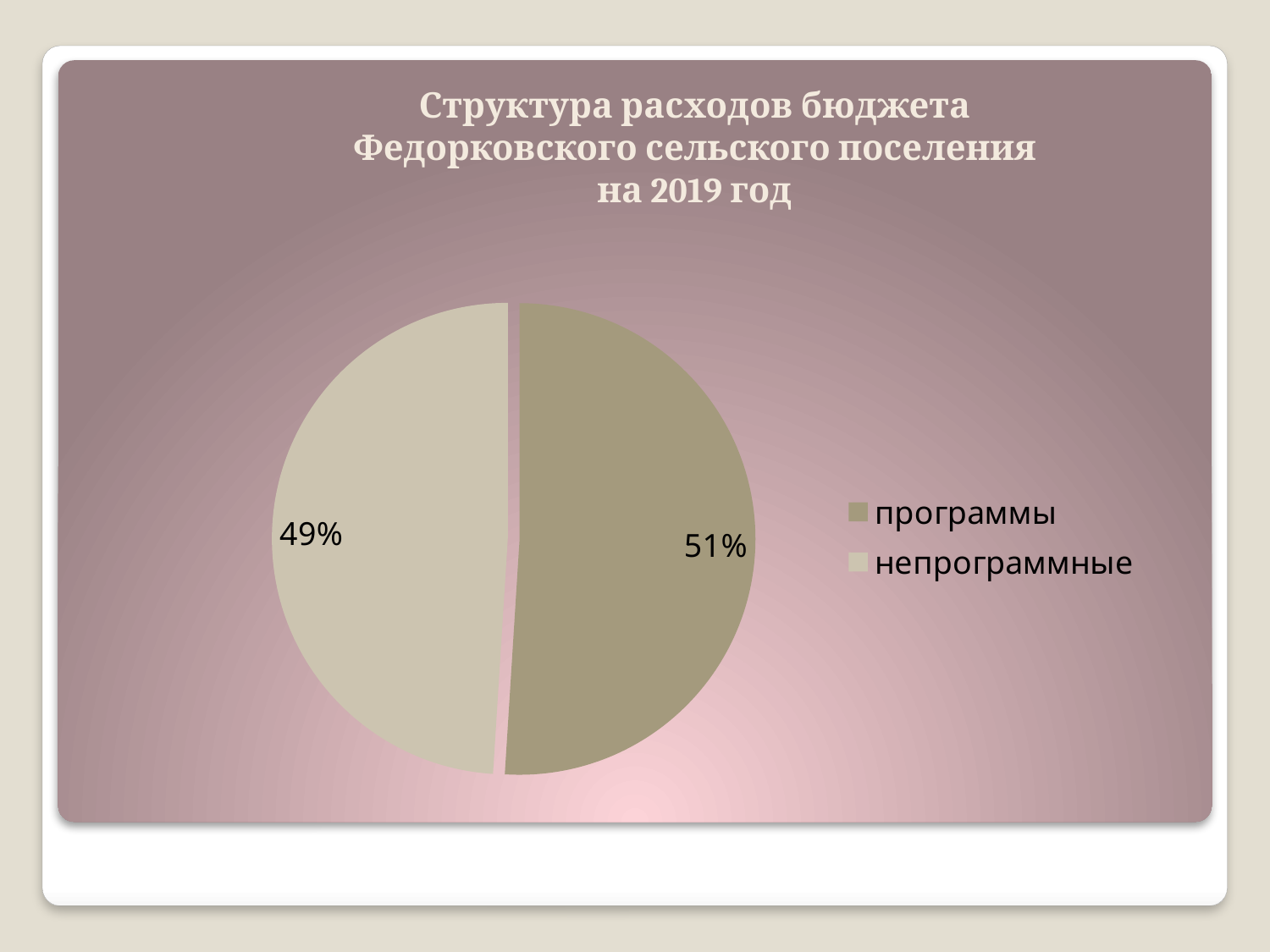
What share of the pie does the "программы" slice represent? 51% What year does the chart title refer to? 2019 How many slices does the pie chart have? 2 Which is larger: the "программы" slice or the "непрограммные" slice? программы How many entries does the legend list? 2 Which legend entry is shown in the lighter colour? непрограммные What share of the pie does the "непрограммные" slice represent? 49% Which category has the smallest slice of the pie? непрограммные What is the total of the two slices shown in the pie chart? 100% What is the difference in percentage points between the "программы" and "непрограммные" slices? 2% What kind of chart is shown on the slide? pie chart Which category has the largest slice of the pie? программы